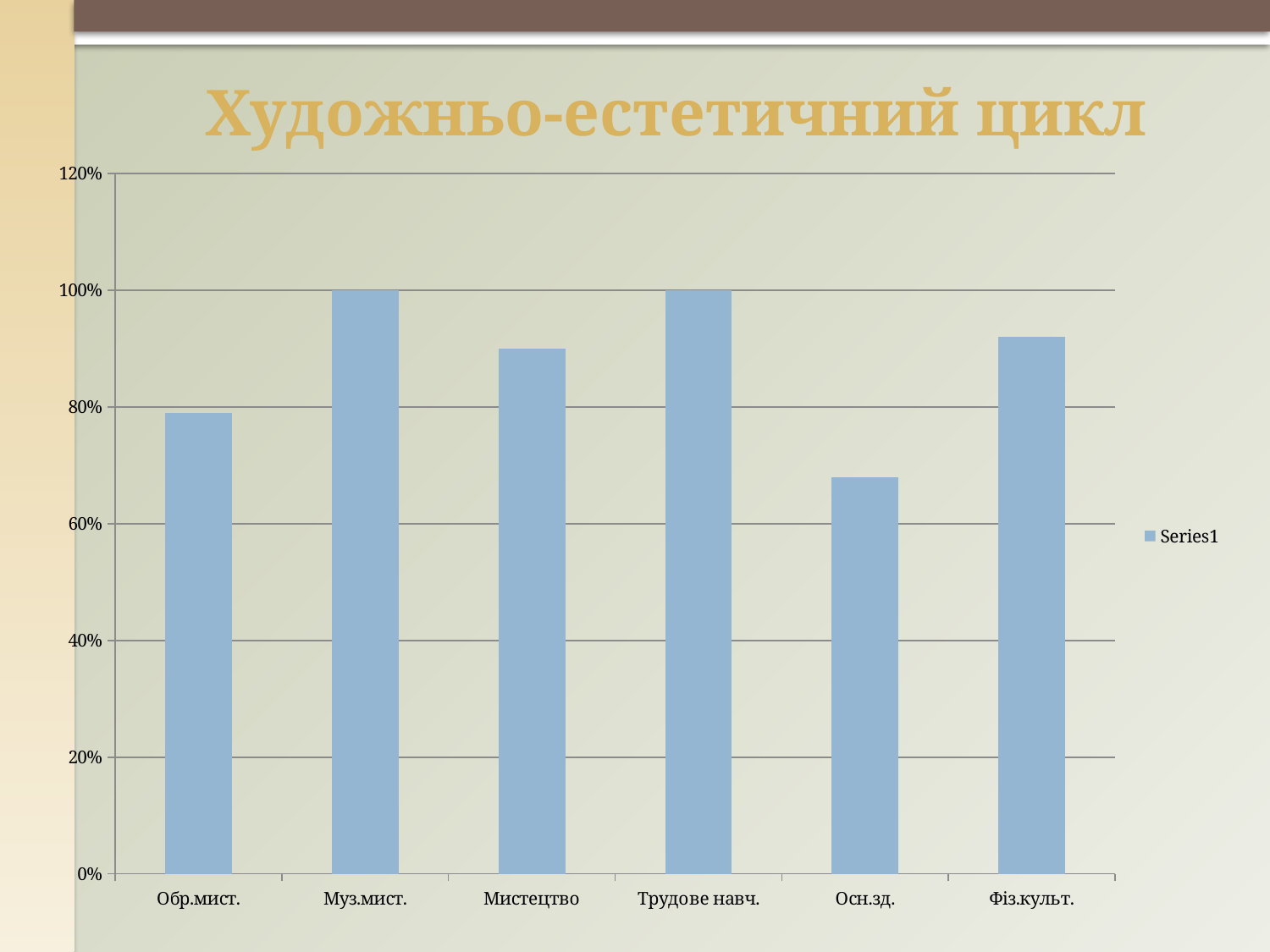
Which is larger, the value for Мистецтво or the value for Осн.зд.? Мистецтво What is the value for Трудове навч.? 100% How many series does the legend list? 1 Is the value for Осн.зд. greater or less than 60%? greater What is the title of the chart? Художньо-естетичний цикл What is the name of the series shown in the legend? Series1 What is the value for Муз.мист.? 100% Which category has the lowest value in the chart? Осн.зд. How many categories are shown on the x axis of the chart? 6 What type of chart is shown on the slide? bar chart Is the value for Фіз.культ. greater or less than 80%? greater